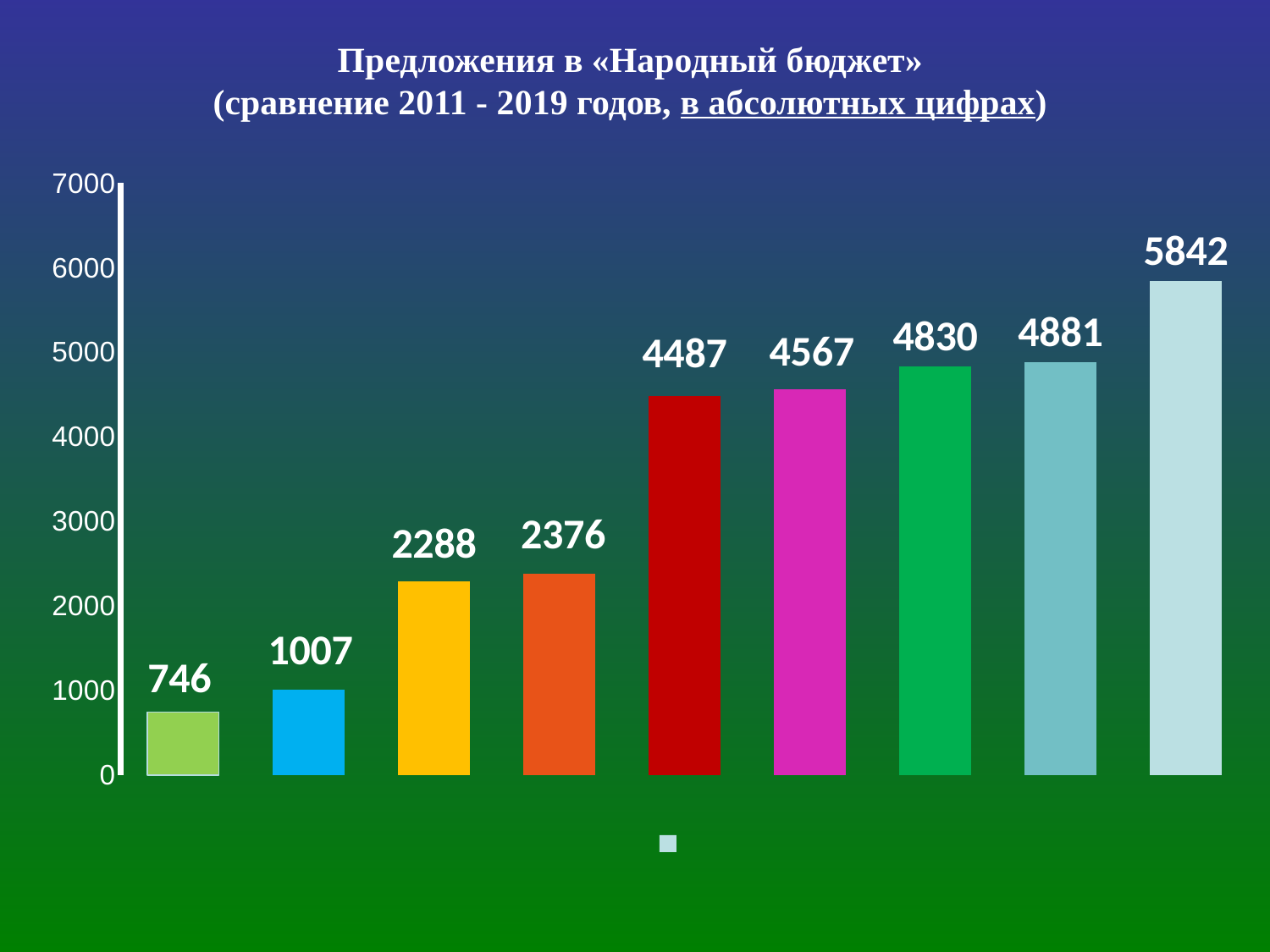
What is the value shown on the leftmost bar? 746 What is the difference between the rightmost bar (5842) and the leftmost bar (746)? 5096 Is the value of the orange bar greater or less than 2000? greater What is the value shown on the third bar from the left? 2288 How many bars are plotted in the chart? 9 What kind of chart is shown on the slide? bar chart What is the value shown on the rightmost bar? 5842 Do the bar values rise or fall from left to right across the chart? rise Which bar has the highest value? the rightmost bar (5842) Which bar has the lowest value? the leftmost bar (746) Which is larger, the value of the magenta bar or the value of the dark red bar? the magenta bar (4567) What is the value shown on the dark red bar? 4487